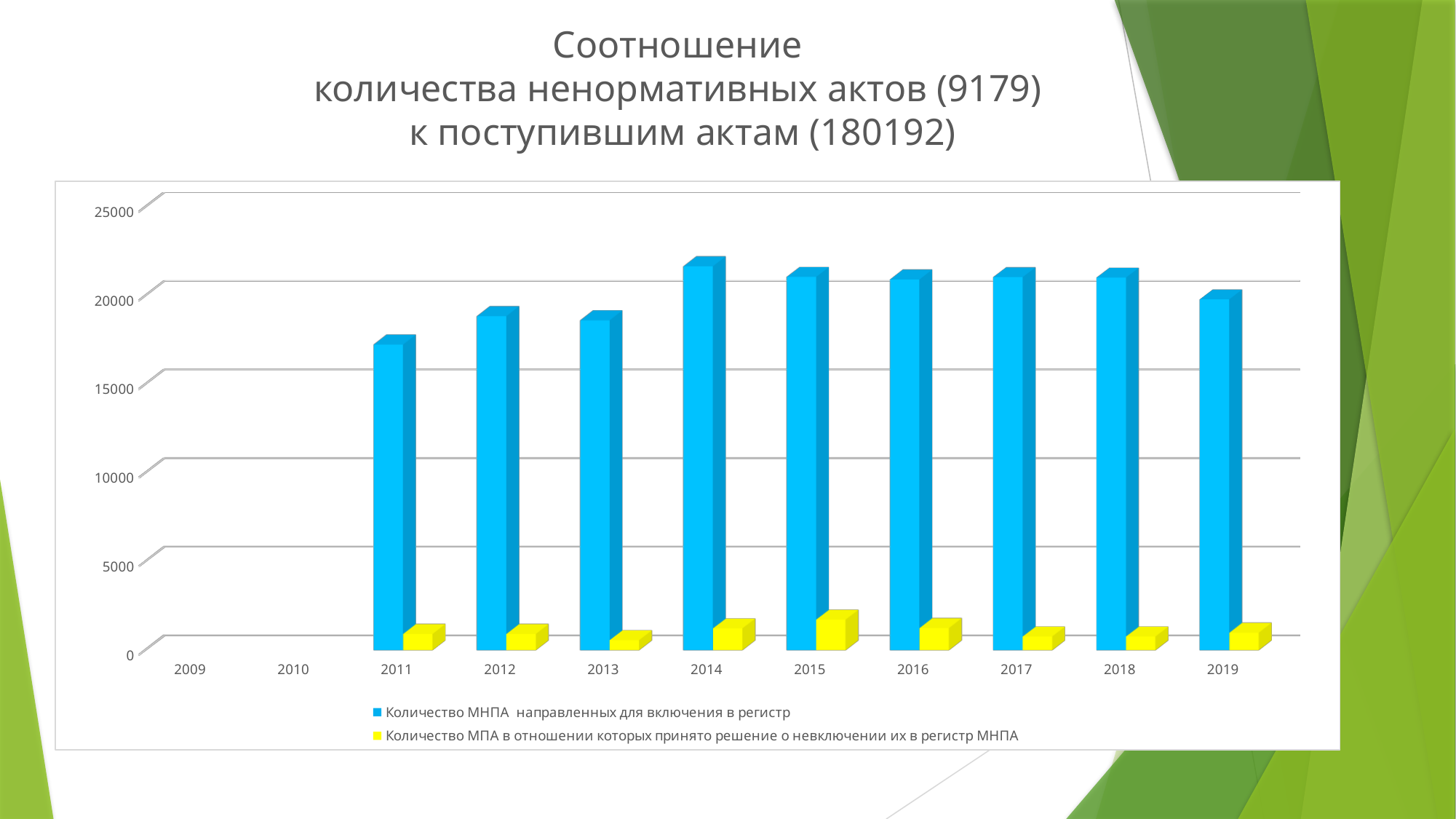
Among the years with bars, which year has the lowest value for 'Количество МПА в отношении которых принято решение о невключении их в регистр МНПА'? 2013 Is the value for 'Количество МНПА направленных для включения в регистр' in 2012 greater or less than 20000? less How many series does the chart legend list? 2 Is the value for 'Количество МНПА направленных для включения в регистр' in 2011 greater or less than 15000? greater How many year categories are shown on the x axis? 11 Which colour represents 'Количество МПА в отношении которых принято решение о невключении их в регистр МНПА' in the legend? Yellow Among the years with bars, which year has the lowest value for 'Количество МНПА направленных для включения в регистр'? 2011 What kind of chart is shown on the slide? Bar chart Is the value for 'Количество МНПА направленных для включения в регистр' in 2014 greater or less than 20000? greater Which is larger: the 'Количество МНПА направленных для включения в регистр' value for 2011 or for 2014? 2014 Which year has the highest value for 'Количество МНПА направленных для включения в регистр'? 2014 Which year has the highest value for 'Количество МПА в отношении которых принято решение о невключении их в регистр МНПА'? 2015